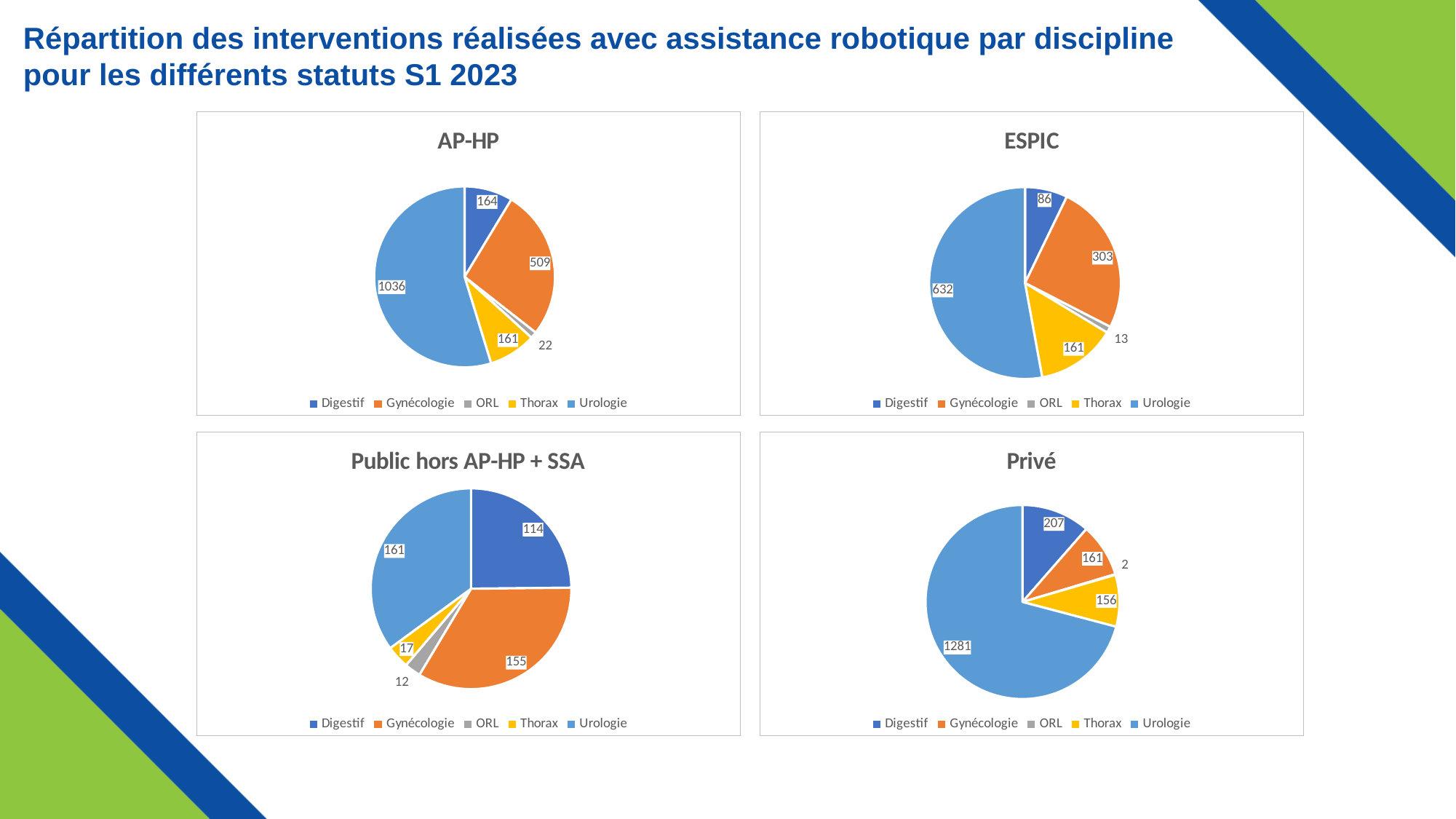
In the AP-HP chart, what is the difference between Gynécologie and Digestif? 345 In the ESPIC chart, what is the value for Gynécologie? 303 In the Public hors AP-HP + SSA chart, which discipline has the largest value? Urologie How many entries does the legend of the ESPIC chart list? 5 In the AP-HP chart, what is the value for Urologie? 1036 What type of chart is the Privé chart? Pie chart In the Public hors AP-HP + SSA chart, what is the total of all slices? 459 In the Privé chart, what share of the total does Urologie represent? 70.9% In the ESPIC chart, which discipline has the smallest value? ORL How many slices does the Public hors AP-HP + SSA pie chart have? 5 In the Privé chart, what is the value for ORL? 2 In the Privé chart, which is larger, Digestif or Thorax? Digestif